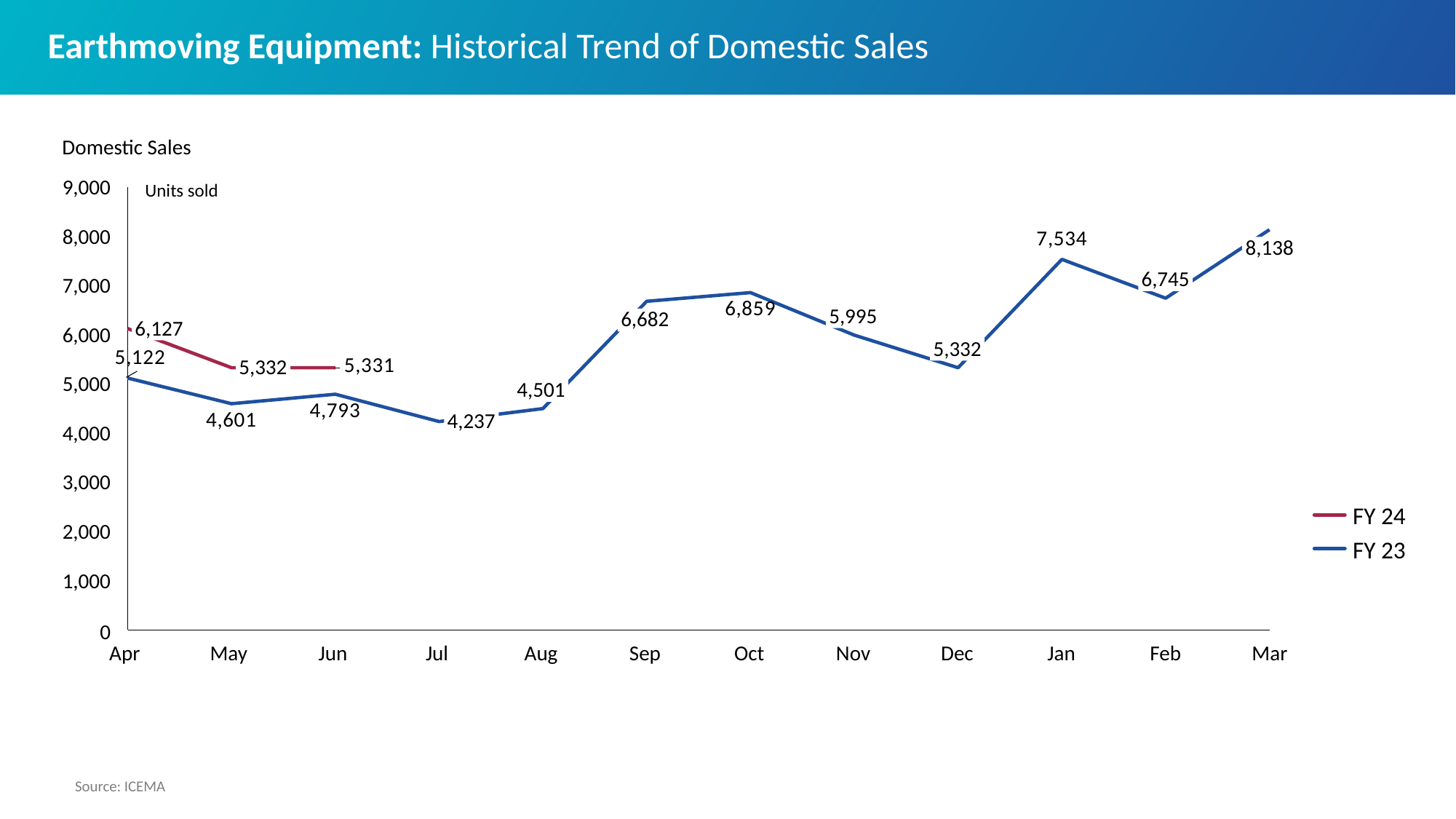
Which is larger, the FY 23 value for Sep or the FY 23 value for Oct? Oct Does the FY 24 line rise or fall from Apr to May? fall Is the FY 23 value for Dec greater or less than 6,000? less What kind of chart is shown? line chart What is the difference between the FY 24 and FY 23 values for Apr? 1,005 What is the FY 23 value for Jan? 7,534 How many months are shown on the x axis? 12 What is the FY 23 value for Apr? 5,122 Which month has the lowest FY 23 value? Jul Which month has the highest FY 23 value? Mar What is the FY 24 value for Jun? 5,331 How many series does the legend list? 2